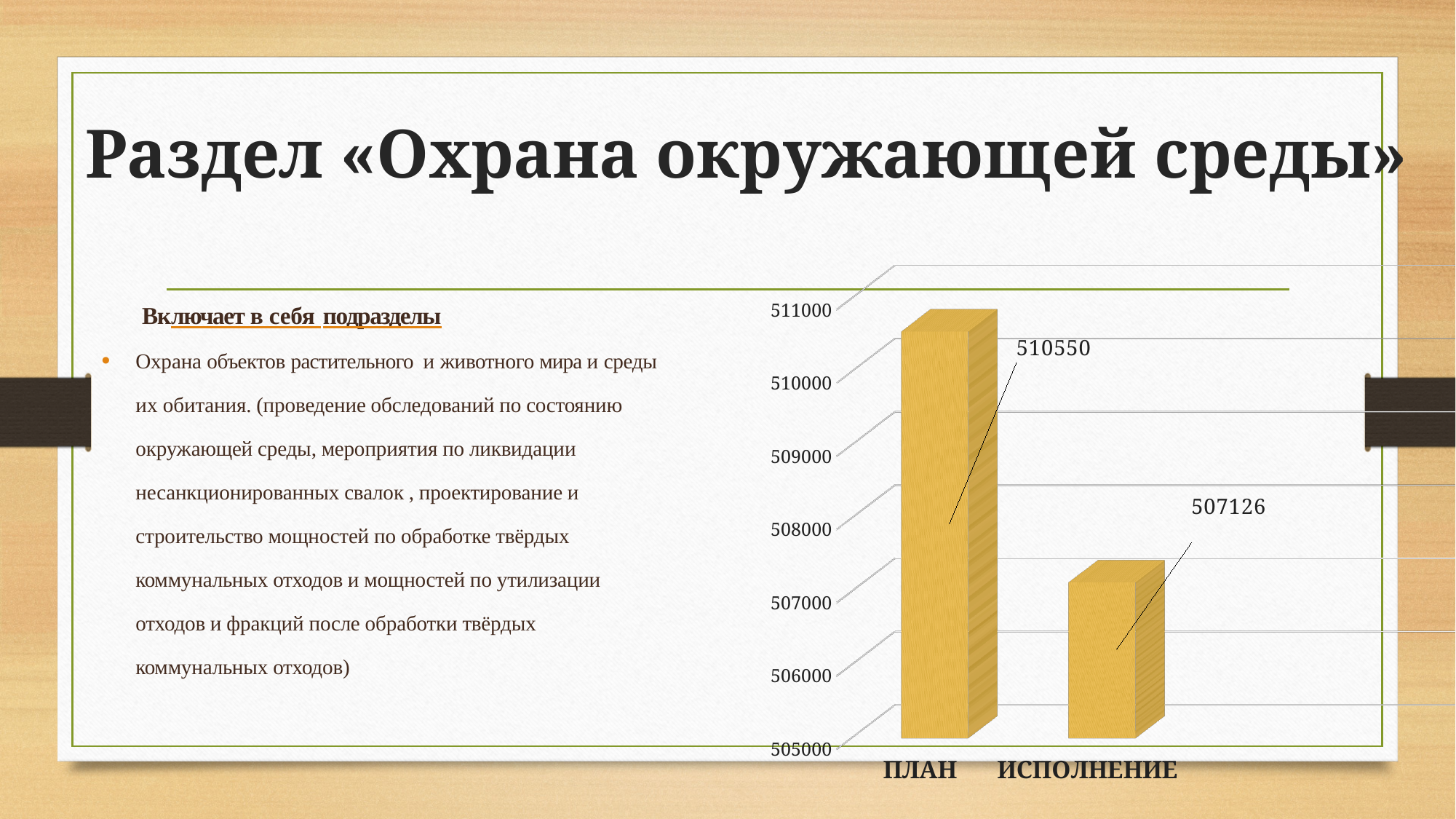
What is the value for ИСПОЛНЕНИЕ? 507126 What is the lowest value shown on the vertical axis? 505000 Is the value for ПЛАН greater or less than 510000? greater Which category has the highest value? ПЛАН What kind of chart is shown on the slide? bar chart Is the value for ИСПОЛНЕНИЕ greater or less than 508000? less What is the highest value shown on the vertical axis? 511000 Which is larger, the value for ПЛАН or the value for ИСПОЛНЕНИЕ? ПЛАН Which category has the lowest value? ИСПОЛНЕНИЕ What is the value for ПЛАН? 510550 What is the difference between the values for ПЛАН and ИСПОЛНЕНИЕ? 3424 How many bars are shown in the chart? 2